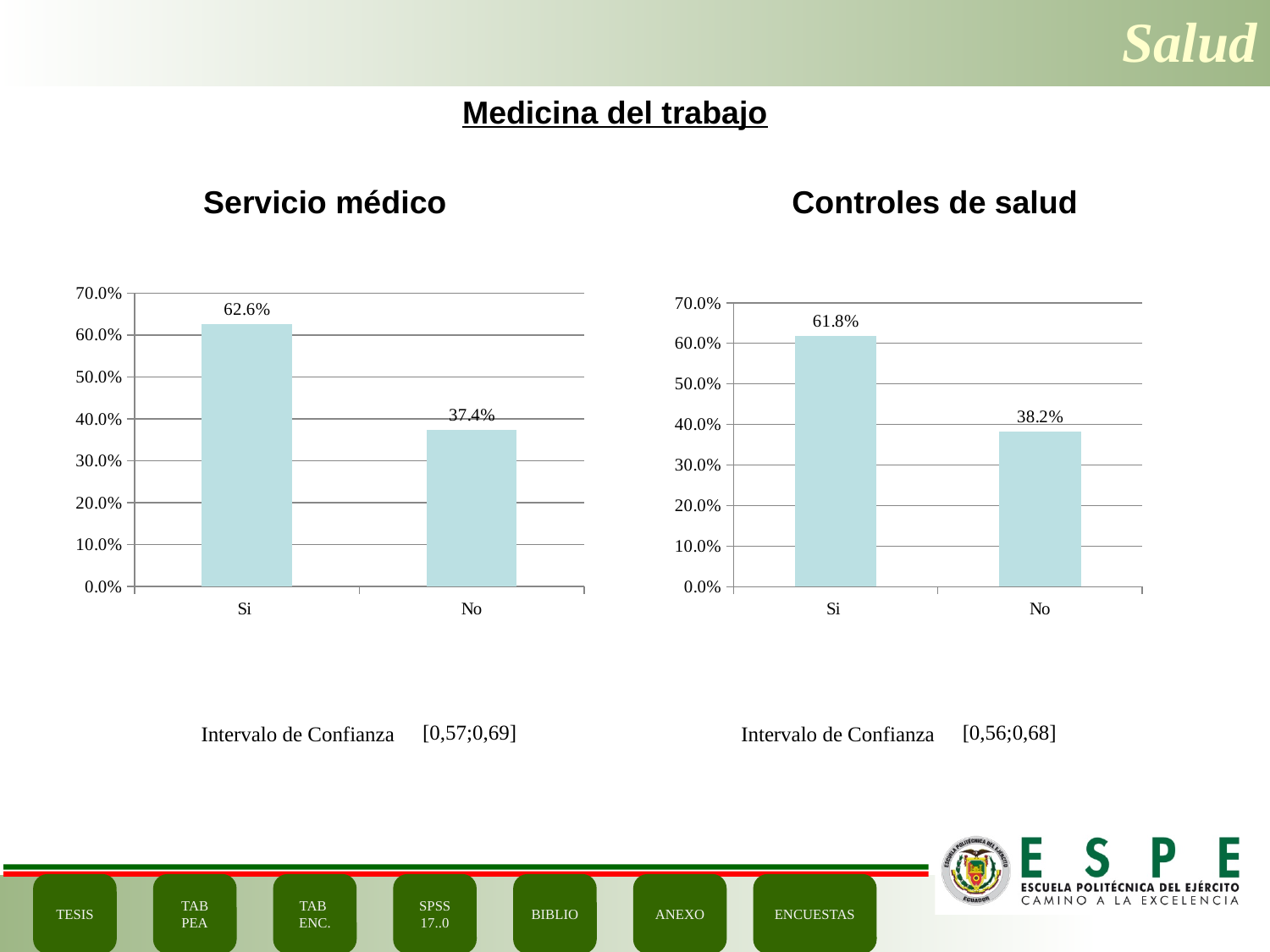
In the 'Controles de salud' chart, what is the value for Si? 61.8% In the 'Servicio médico' chart, what is the value for No? 37.4% In the 'Servicio médico' chart, what is the value for Si? 62.6% In the 'Controles de salud' chart, is the value for Si greater or less than 60.0%? greater What type of chart is the 'Controles de salud' chart? Bar chart What is the confidence interval (Intervalo de Confianza) shown below the 'Servicio médico' chart? [0,57;0,69] In the 'Controles de salud' chart, what is the difference between the values for Si and No? 23.6% In the 'Controles de salud' chart, which category has the lowest value? No In the 'Servicio médico' chart, which category has the highest value? Si In the 'Servicio médico' chart, what is the difference between the values for Si and No? 25.2% How many categories are shown in the 'Servicio médico' chart? 2 In the 'Controles de salud' chart, what is the value for No? 38.2%